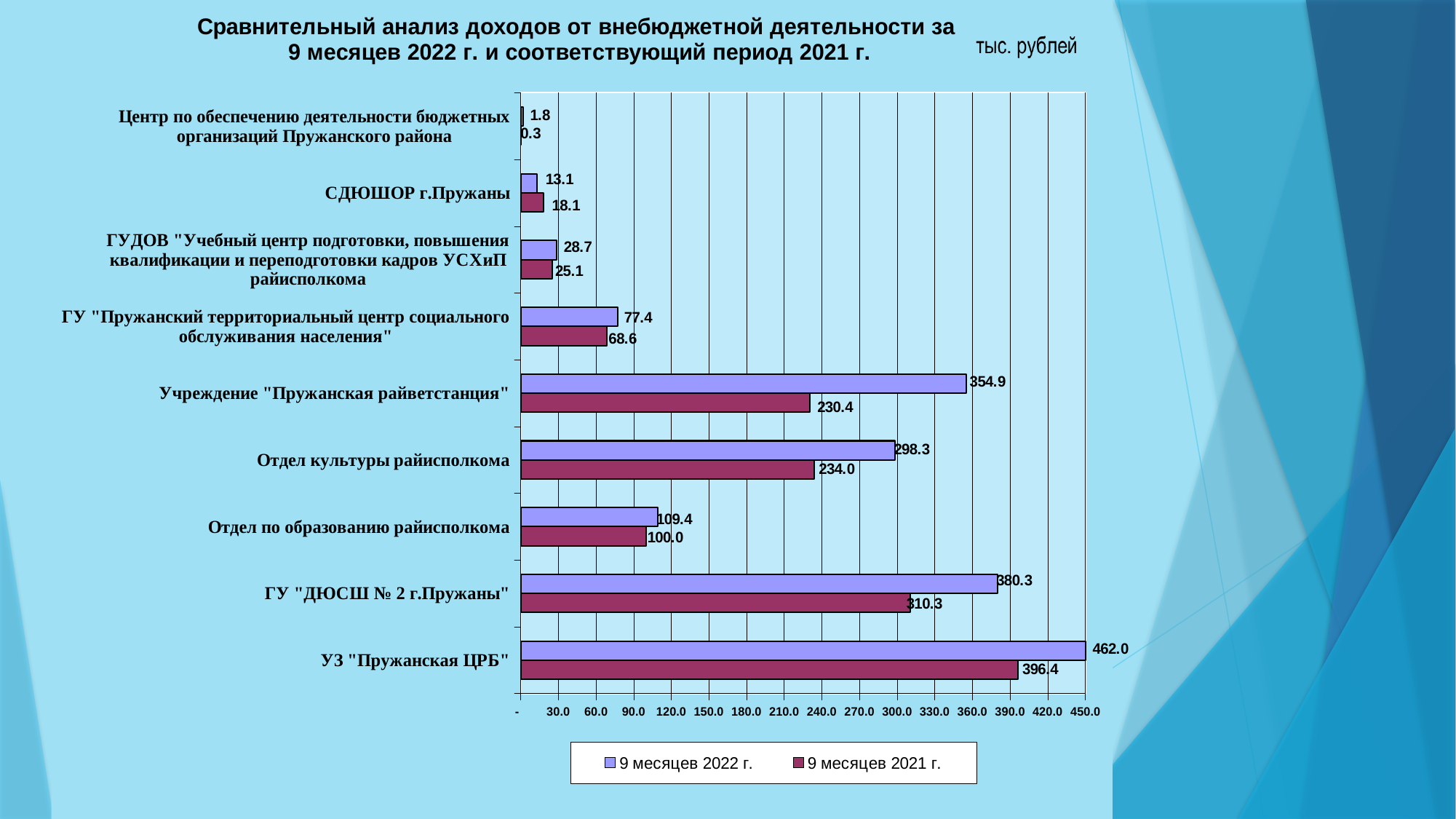
Is the 9 месяцев 2022 г. value for Учреждение "Пружанская райветстанция" greater or less than 300.0? greater For СДЮШОР г.Пружаны, which series has the larger value: 9 месяцев 2022 г. or 9 месяцев 2021 г.? 9 месяцев 2021 г. What unit of measurement is indicated next to the chart title? тыс. рублей What is the difference between the 9 месяцев 2022 г. and 9 месяцев 2021 г. values for ГУ "ДЮСШ № 2 г.Пружаны"? 70.0 What is the value for СДЮШОР г.Пружаны in the 9 месяцев 2022 г. series? 13.1 How many series does the legend list? 2 What is the value for УЗ "Пружанская ЦРБ" in the 9 месяцев 2022 г. series? 462.0 Which category has the highest value in the 9 месяцев 2021 г. series? УЗ "Пружанская ЦРБ" How many categories (organisations) are shown on the chart? 9 What is the value for Отдел культуры райисполкома in the 9 месяцев 2021 г. series? 234.0 Which category has the lowest value in the 9 месяцев 2022 г. series? Центр по обеспечению деятельности бюджетных организаций Пружанского района What kind of chart is shown on the slide? Bar chart